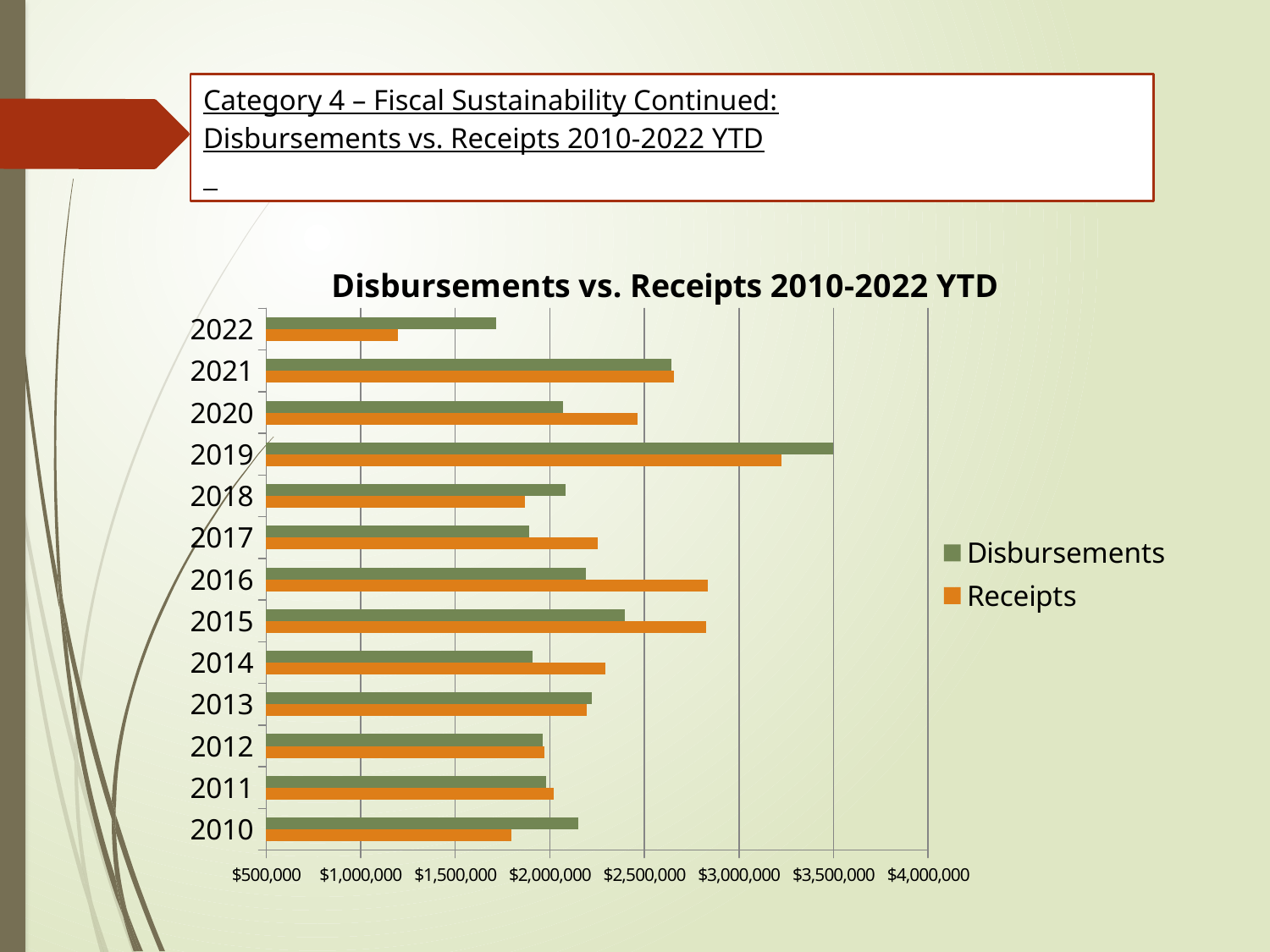
Which year has the lowest Disbursements? 2022 Which year has the lowest Receipts? 2022 Is the value for Receipts in 2016 greater or less than $2,500,000? greater What is the title of the chart? Disbursements vs. Receipts 2010-2022 YTD Is the value for Receipts in 2022 greater or less than $1,500,000? less Is the value for Disbursements in 2019 greater or less than $3,000,000? greater Which colour represents Receipts in the chart? Orange How many series does the legend list? 2 What kind of chart is shown on the slide? Bar chart In 2010, which is larger, Disbursements or Receipts? Disbursements Which year has the highest Disbursements? 2019 How many years are shown on the chart? 13